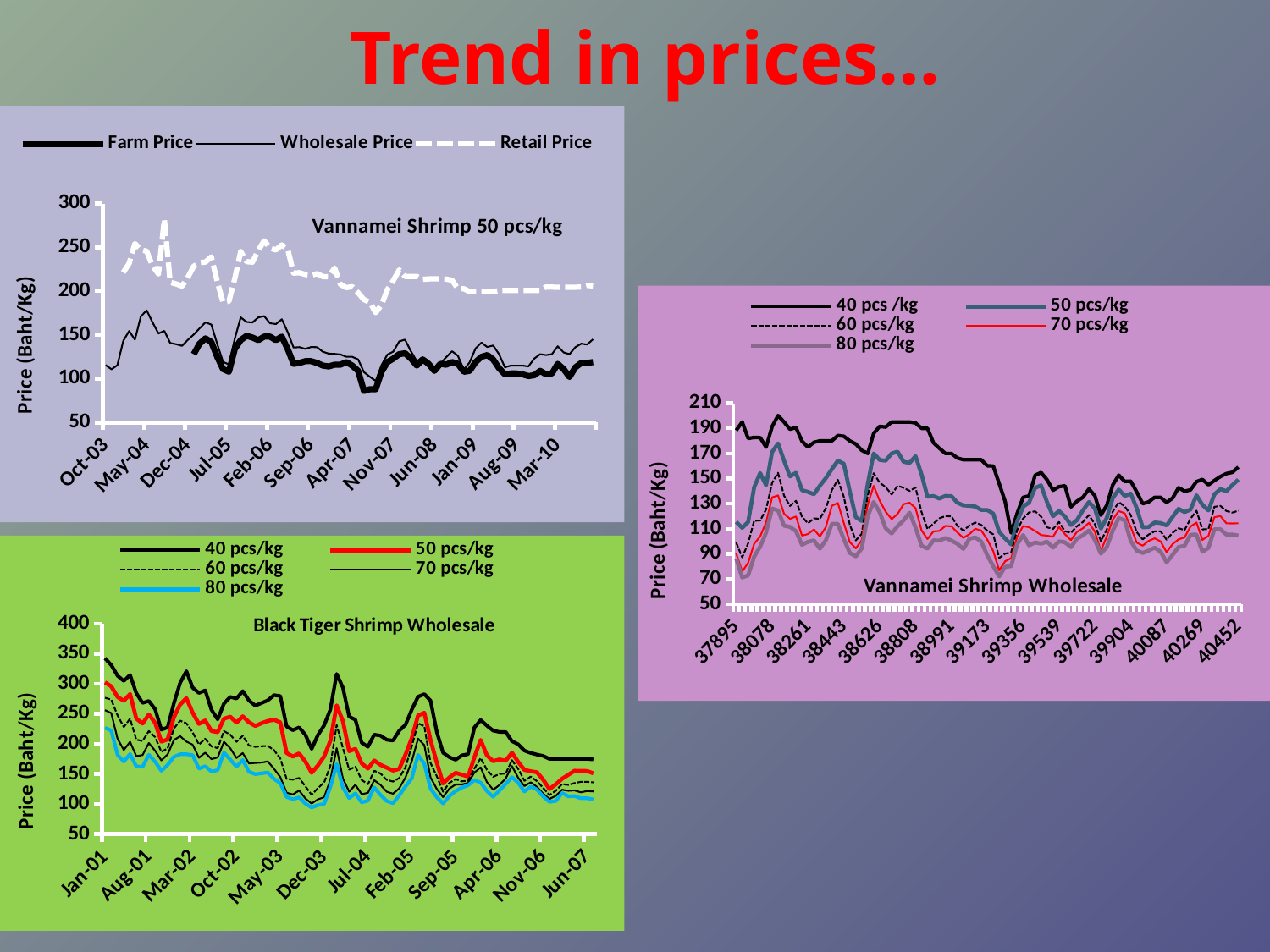
In the 'Vannamei Shrimp 50 pcs/kg' chart, is the Retail Price at Mar-10 greater or less than 150? greater How many series does the legend of the 'Vannamei Shrimp 50 pcs/kg' chart list? 3 In the 'Black Tiger Shrimp Wholesale' chart, which size series has the highest prices throughout? 40 pcs/kg What is the y-axis label of the 'Vannamei Shrimp Wholesale' chart? Price (Baht/Kg) In the 'Vannamei Shrimp Wholesale' chart on the right, which series has the lowest prices throughout? 80 pcs/kg In the 'Vannamei Shrimp 50 pcs/kg' chart, is the Farm Price at its lowest point around Nov-07 greater or less than 100? less In the 'Black Tiger Shrimp Wholesale' chart, which is larger at Jun-07: the 40 pcs/kg price or the 80 pcs/kg price? 40 pcs/kg In the 'Vannamei Shrimp 50 pcs/kg' chart, which series is plotted highest across the whole period? Retail Price In the 'Black Tiger Shrimp Wholesale' chart, is the 40 pcs/kg price at Jan-01 greater or less than 300? greater In the 'Black Tiger Shrimp Wholesale' chart, do prices generally rise or fall from Jan-01 to Jun-07? fall What kind of chart is the 'Vannamei Shrimp 50 pcs/kg' chart at the top left? Line chart How many series does the legend of the 'Black Tiger Shrimp Wholesale' chart list? 5